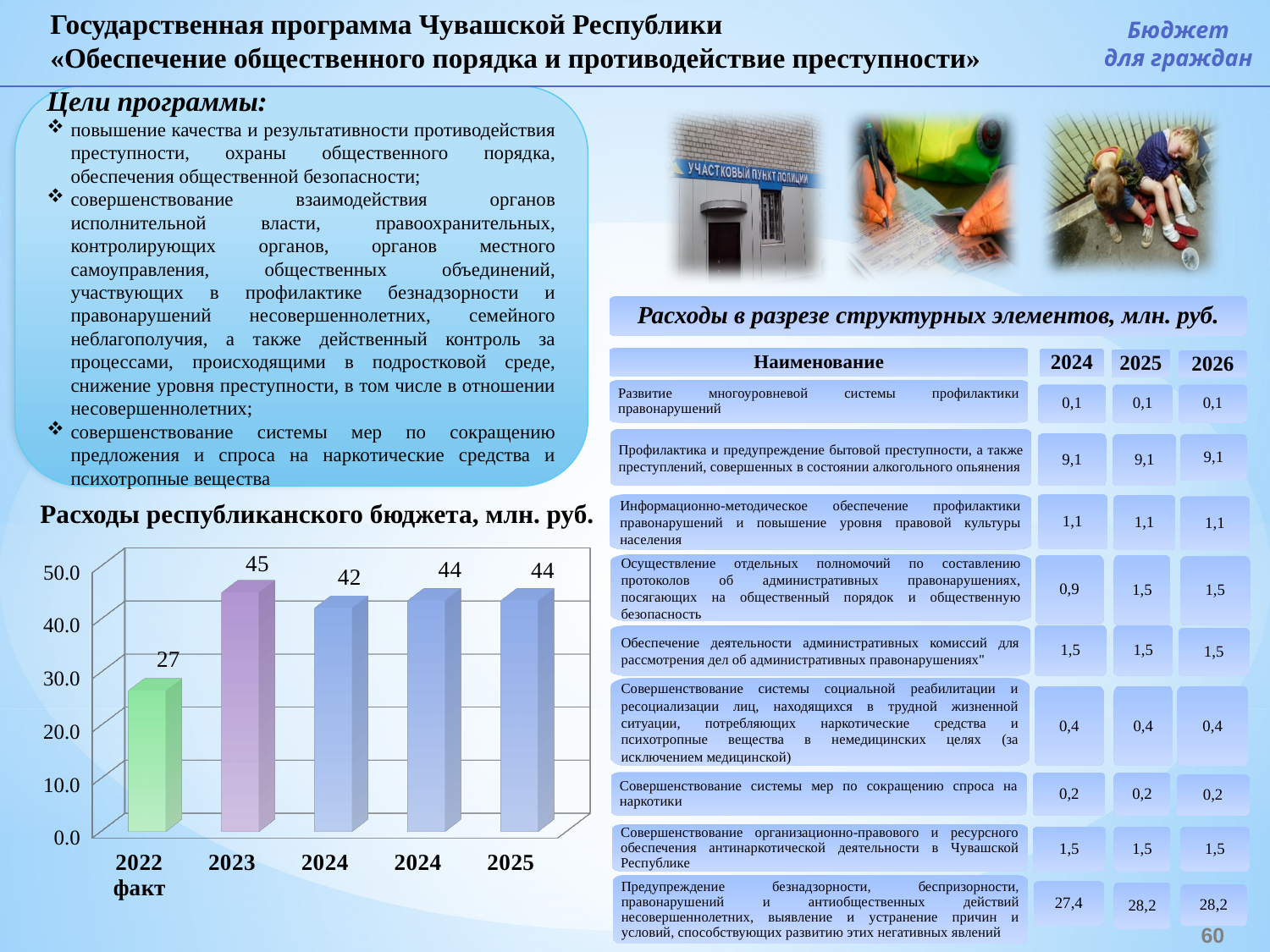
What is the value of the third bar from the left in the chart 'Расходы республиканского бюджета, млн. руб.'? 42 How many bars are shown in the chart 'Расходы республиканского бюджета, млн. руб.'? 5 Does the value rise or fall from 2022 факт to 2023 in the chart 'Расходы республиканского бюджета, млн. руб.'? rise What is the difference between the values for 2023 and 2022 факт in the chart 'Расходы республиканского бюджета, млн. руб.'? 18 Is the value for 2022 факт in the chart 'Расходы республиканского бюджета, млн. руб.' greater or less than 30.0? less Which category has the highest value in the chart 'Расходы республиканского бюджета, млн. руб.'? 2023 What is the value for 2025 in the chart 'Расходы республиканского бюджета, млн. руб.'? 44 What is the value for 2022 факт in the chart 'Расходы республиканского бюджета, млн. руб.'? 27 What kind of chart is 'Расходы республиканского бюджета, млн. руб.'? bar chart What is the value for 2023 in the chart 'Расходы республиканского бюджета, млн. руб.'? 45 Which category has the lowest value in the chart 'Расходы республиканского бюджета, млн. руб.'? 2022 факт Which is larger in the chart 'Расходы республиканского бюджета, млн. руб.': the value for 2022 факт or the value for 2023? 2023